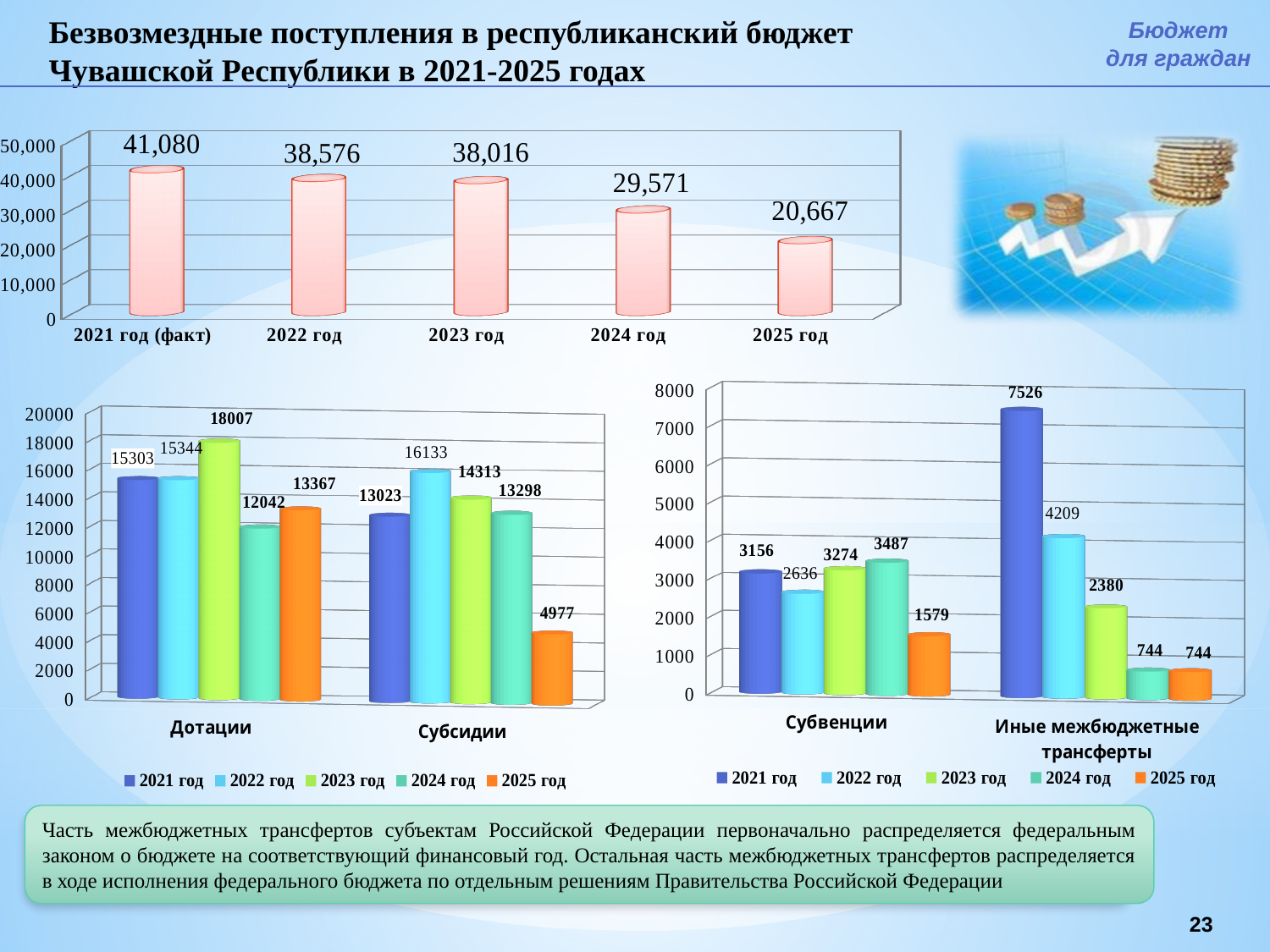
In the bottom-right chart, which is larger for Субвенции: 2022 год or 2024 год? 2024 год What kind of chart is the bottom-right chart? bar chart In the bottom-left chart, which year has the highest value for Субсидии? 2022 год In the top chart, what is the value for 2021 год (факт)? 41,080 In the bottom-left chart, what is the difference between Субсидии in 2024 год and 2025 год? 8321 In the top chart, what is the difference between the values for 2022 год and 2025 год? 17,909 In the bottom-left chart, what is the value for Дотации in 2023 год? 18007 In the top chart, how many bars are plotted? 5 In the top chart, do the values rise or fall from 2021 to 2025? fall In the bottom-left chart, how many series does the legend list? 5 In the top chart, which year has the lowest value? 2025 год In the bottom-right chart, what is the value for Иные межбюджетные трансферты in 2021 год? 7526